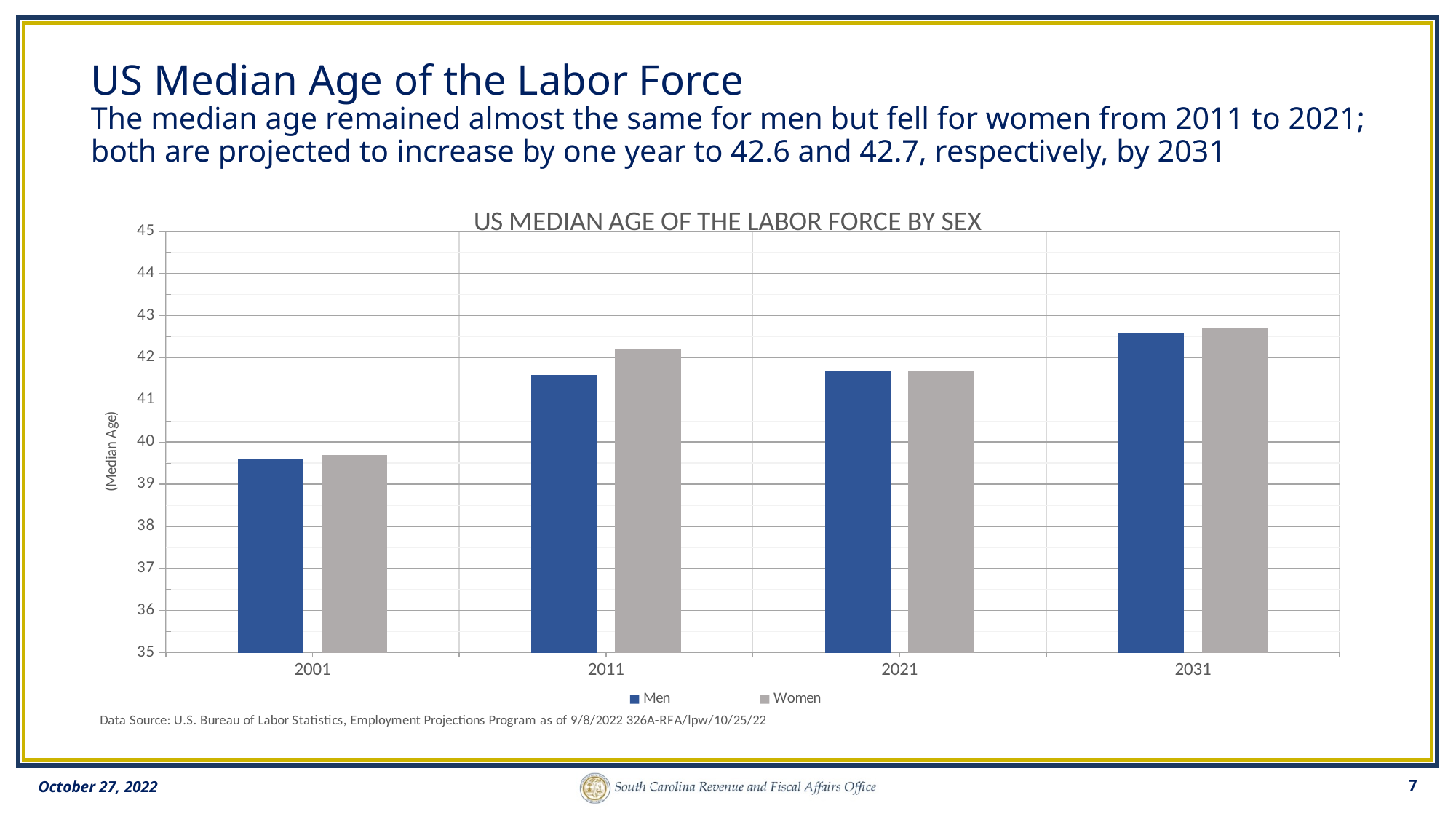
What is the title of the chart? US MEDIAN AGE OF THE LABOR FORCE BY SEX How many years are shown on the x axis of the chart? 4 Does the median age for Men rise or fall from 2001 to 2031? rise What is the projected median age for Men in 2031? 42.6 How many series does the legend list? 2 In 2011, which is larger, the median age for Men or for Women? Women In which year is the median age for Men highest? 2031 Is the median age for Women in 2011 greater or less than 41? greater Is the median age for Men in 2001 greater or less than 40? less What is the projected median age for Women in 2031? 42.7 What kind of chart is shown on the slide? bar chart In which year is the median age for Women lowest? 2001